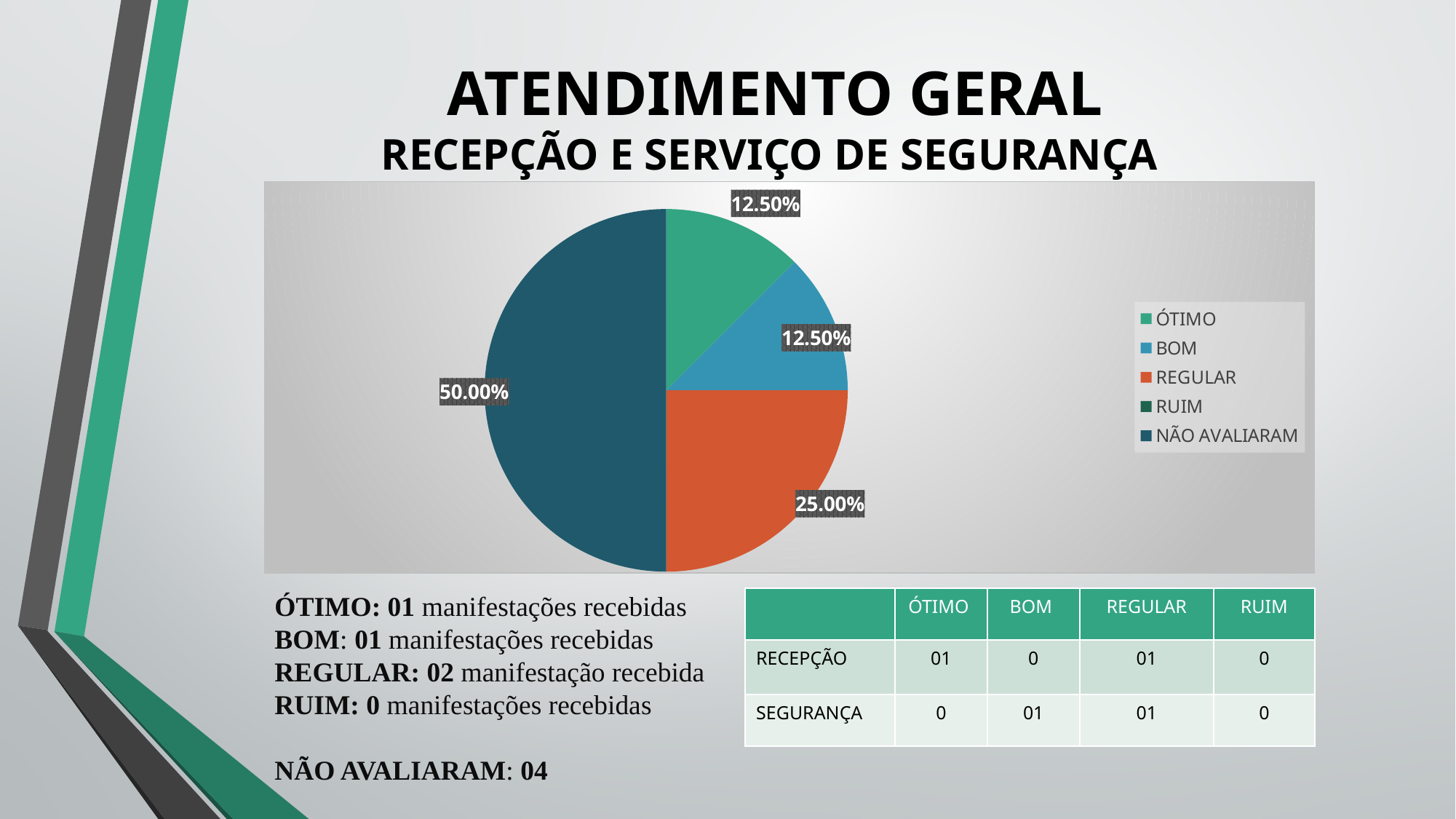
What kind of chart is shown on the slide? pie chart Is the share for NÃO AVALIARAM greater or less than 40%? greater How many entries does the legend list? 5 What share of the pie does BOM represent? 12.50% Which category has the largest slice of the pie? NÃO AVALIARAM What share of the pie does ÓTIMO represent? 12.50% What share of the pie does REGULAR represent? 25.00% What is the difference between the NÃO AVALIARAM share and the REGULAR share? 25.00% Which legend entry has no visible slice in the pie chart? RUIM Which is larger, the REGULAR slice or the BOM slice? REGULAR What colour is the REGULAR slice in the pie chart? orange